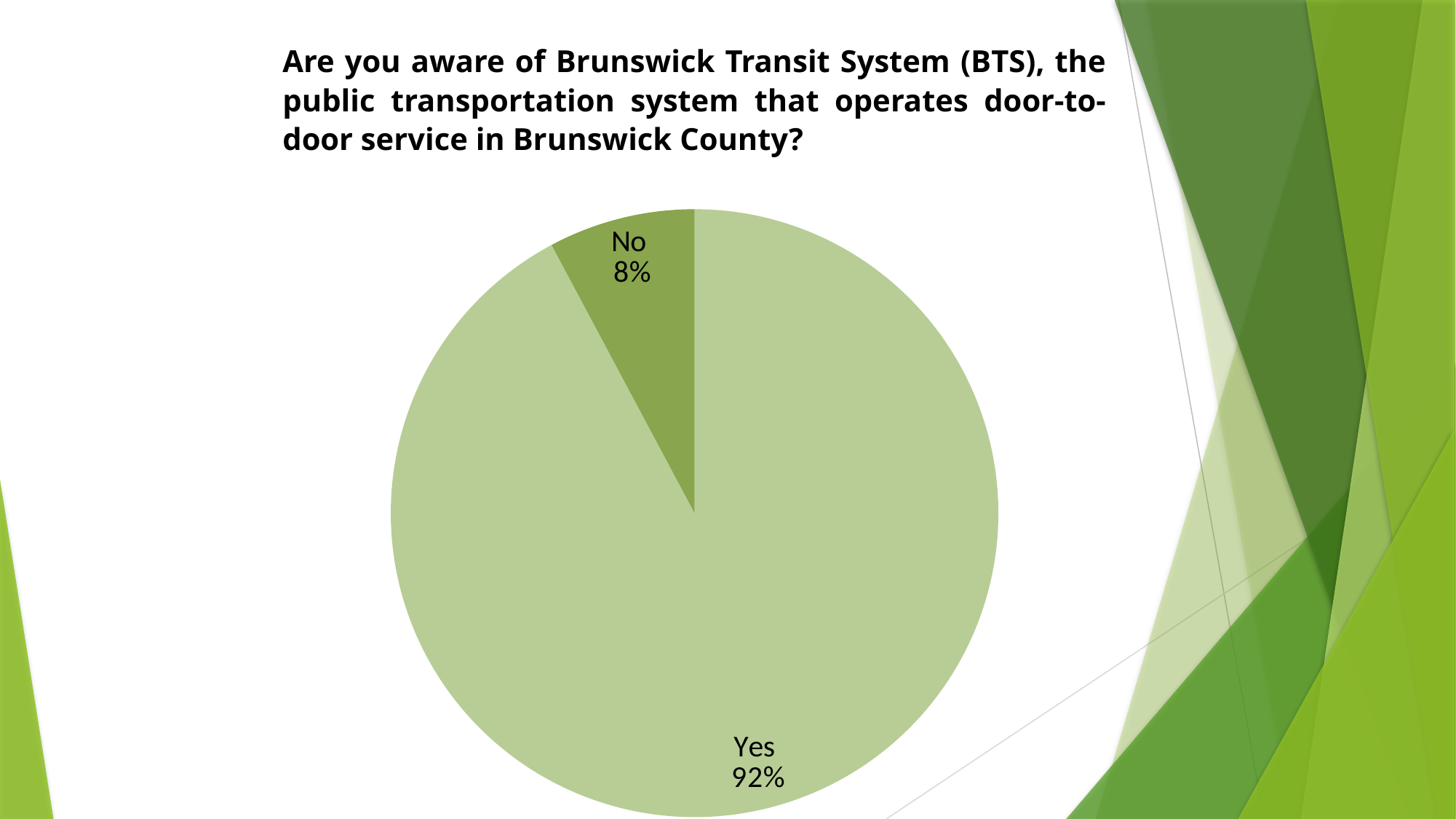
Which slice is shaded the darker green, Yes or No? No What share of the pie does the No slice represent? 8% What percentage of respondents answered Yes? 92% What percentage of respondents answered No? 8% What kind of chart is shown on the slide? pie chart Which response has the largest share of the pie? Yes What is the difference in percentage points between the Yes and No shares? 84 Which is larger, the Yes share or the No share? Yes Which response has the smallest share of the pie? No How many slices does the pie chart have? 2 What question does the chart title ask? Are you aware of Brunswick Transit System (BTS), the public transportation system that operates door-to-door service in Brunswick County?